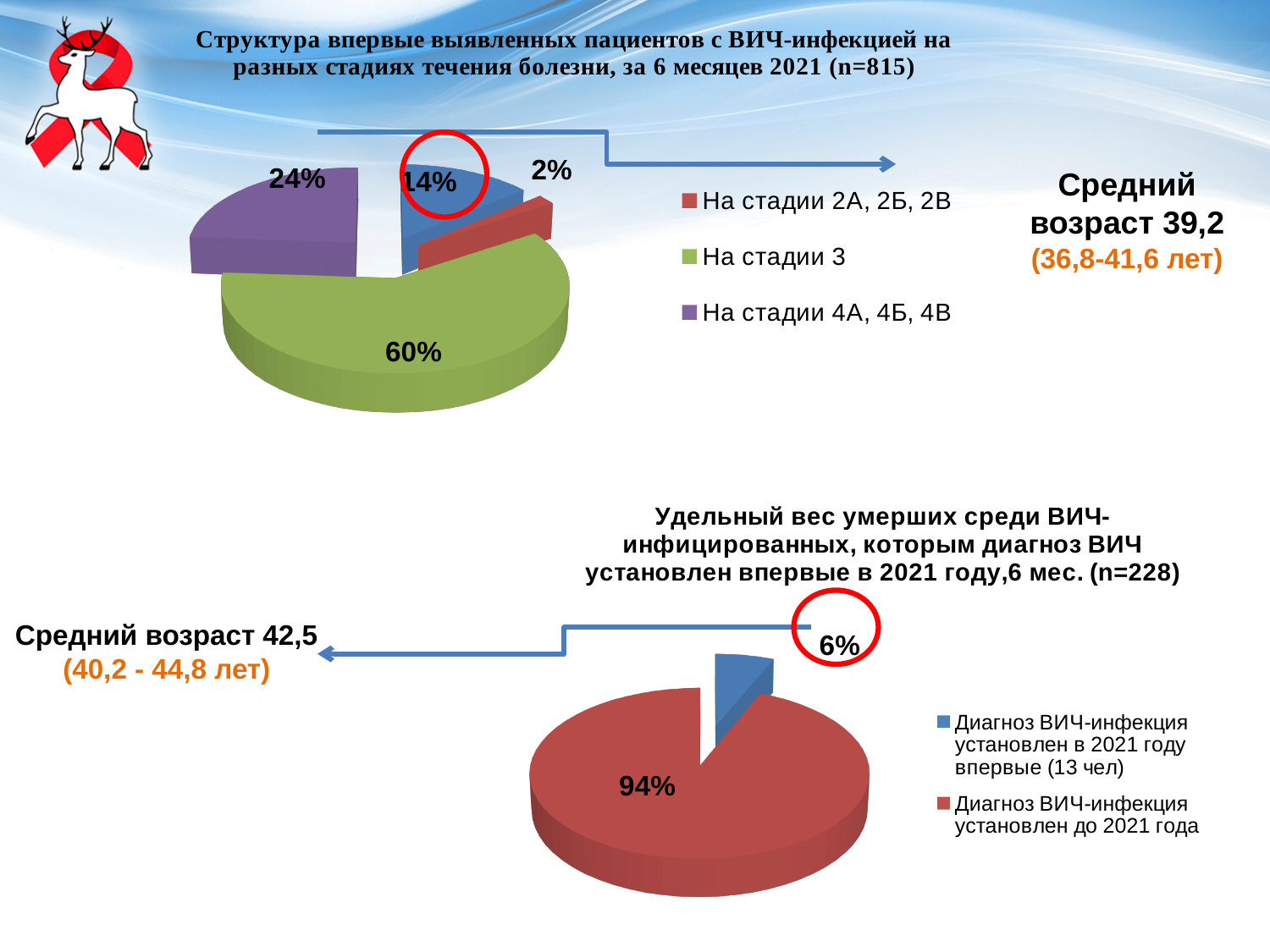
In the bottom chart (Удельный вес умерших среди ВИЧ-инфицированных), what share is shown for 'Диагноз ВИЧ-инфекция установлен в 2021 году впервые (13 чел)'? 6% In the top chart (Структура впервые выявленных пациентов с ВИЧ-инфекцией), what share is shown for 'На стадии 2А, 2Б, 2В'? 2% In the top chart (Структура впервые выявленных пациентов с ВИЧ-инфекцией), what share is shown for 'На стадии 4А, 4Б, 4В'? 24% In the bottom chart (Удельный вес умерших среди ВИЧ-инфицированных), how many slices does the pie have? 2 In the top chart (Структура впервые выявленных пациентов с ВИЧ-инфекцией), which legend category has the smallest slice? На стадии 2А, 2Б, 2В In the bottom chart (Удельный вес умерших среди ВИЧ-инфицированных), what share is shown for 'Диагноз ВИЧ-инфекция установлен до 2021 года'? 94% In the top chart (Структура впервые выявленных пациентов с ВИЧ-инфекцией), which legend category has the largest slice? На стадии 3 What type of chart is the top chart (Структура впервые выявленных пациентов с ВИЧ-инфекцией)? Pie chart In the bottom chart (Удельный вес умерших среди ВИЧ-инфицированных), which category is larger: 'Диагноз ВИЧ-инфекция установлен в 2021 году впервые' or 'Диагноз ВИЧ-инфекция установлен до 2021 года'? Диагноз ВИЧ-инфекция установлен до 2021 года In the top chart (Структура впервые выявленных пациентов с ВИЧ-инфекцией), what share is shown for 'На стадии 3'? 60% In the top chart (Структура впервые выявленных пациентов с ВИЧ-инфекцией), what is the difference in percentage points between 'На стадии 3' and 'На стадии 4А, 4Б, 4В'? 36 percentage points In the top chart (Структура впервые выявленных пациентов с ВИЧ-инфекцией), how many entries does the legend list? 3